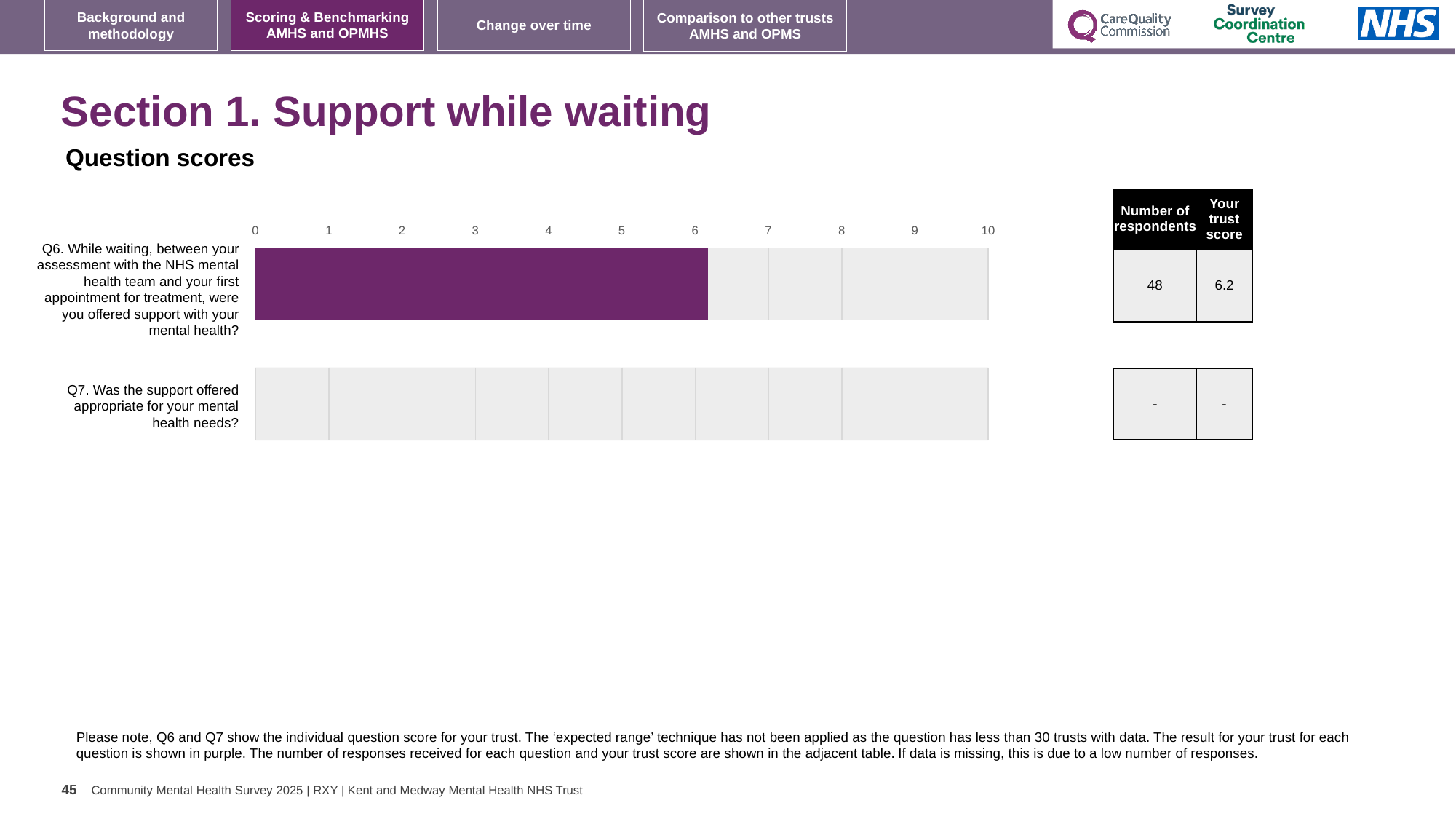
What is the trust score for Q6 shown in the adjacent table? 6.2 What colour is the bar showing the trust's result for Q6? purple Is the value for Q6 greater or less than 8? less What is shown as the trust score for Q7 in the table? - Which question has a plotted bar on the chart? Q6 What is the maximum value shown on the chart's x axis? 10 How many questions (categories) are plotted on the chart? 2 What kind of chart is shown on the slide? bar chart How many respondents answered Q6 according to the table? 48 Is the value for Q6 greater or less than 5? greater Which question has no bar plotted because data is missing? Q7